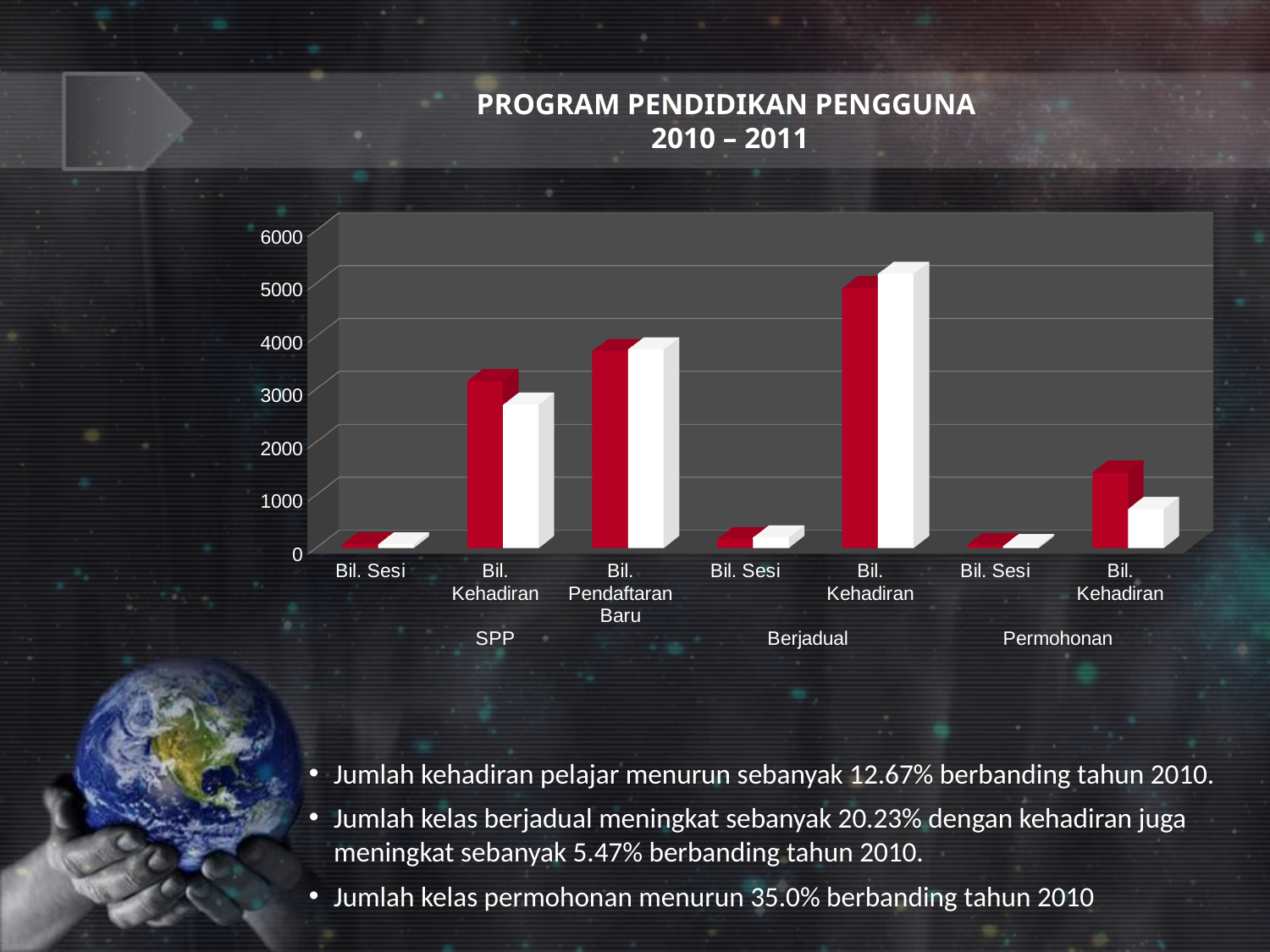
Is the value of the red bar for Bil. Kehadiran (Permohonan) greater or less than 1000? greater What kind of chart is shown on the slide? Bar chart What is the highest value shown on the vertical axis of the chart? 6000 Is the value of the red bar for Bil. Pendaftaran Baru (SPP) greater or less than 3000? greater What are the three group labels shown beneath the categories on the x axis? SPP, Berjadual, Permohonan Is the value of the red bar for Bil. Sesi (SPP) greater or less than 1000? less What is the title of the chart? PROGRAM PENDIDIKAN PENGGUNA 2010 – 2011 For Bil. Kehadiran (Permohonan), which bar is taller, the red bar or the white bar? The red bar Which is larger: the red bar for Bil. Kehadiran under Berjadual or the red bar for Bil. Kehadiran under SPP? Bil. Kehadiran under Berjadual Which category has the tallest bars in the chart? Bil. Kehadiran (Berjadual) How many categories are shown along the x axis of the chart? 7